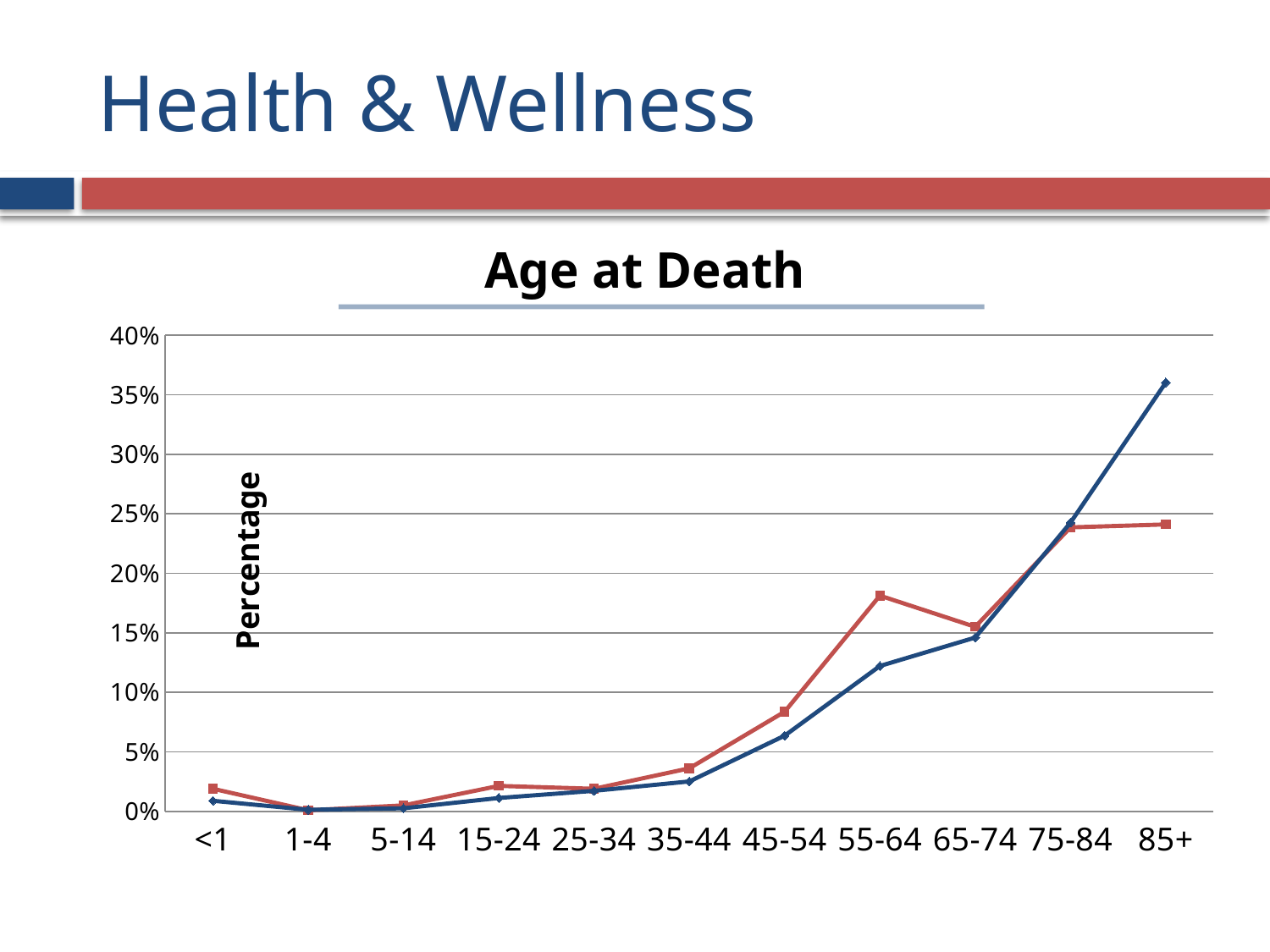
At the 85+ category, which line has the larger value, the blue line or the red line? blue line How many age categories are shown on the x axis? 11 At the 55-64 category, which line has the larger value, the blue line or the red line? red line What is the title of the chart? Age at Death Is the value of the blue line at 45-54 greater or less than 10%? less For the blue line, which age category has the highest value? 85+ What kind of chart is shown on the slide? line chart What is the label on the vertical axis of the chart? Percentage Is the value of the blue line at 85+ greater or less than 30%? greater For the red line, which age category has the highest value? 85+ Overall, do the values of the blue line rise or fall from the youngest to the oldest age category? rise How many lines (series) are plotted on the chart? 2